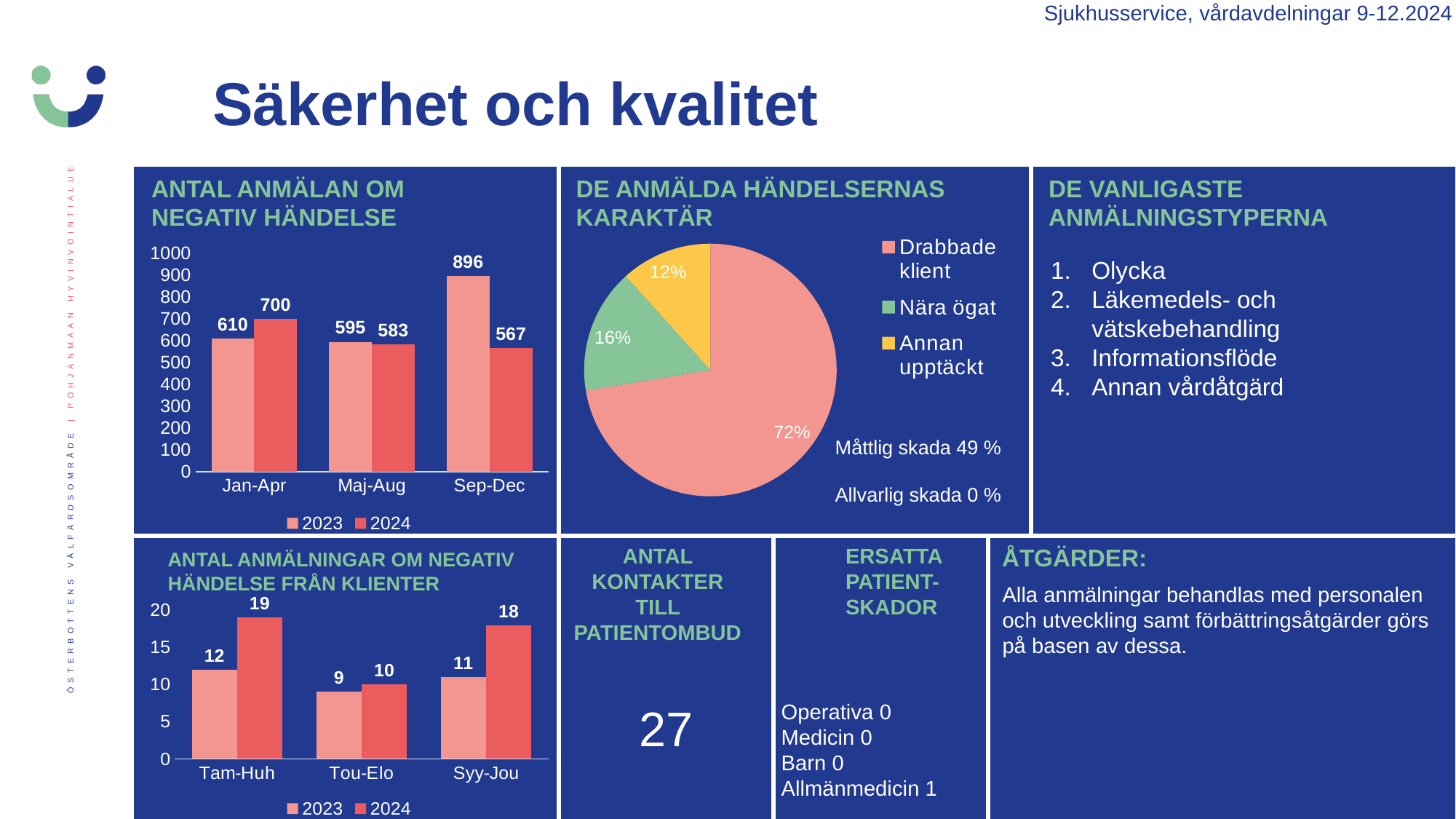
In the chart 'ANTAL ANMÄLAN OM NEGATIV HÄNDELSE', what is the difference between the 2023 and 2024 values in Sep-Dec? 329 In the pie chart 'DE ANMÄLDA HÄNDELSERNAS KARAKTÄR', which category has the largest slice? Drabbade klient In the pie chart 'DE ANMÄLDA HÄNDELSERNAS KARAKTÄR', what share does 'Nära ögat' have? 16% In the chart 'ANTAL ANMÄLNINGAR OM NEGATIV HÄNDELSE FRÅN KLIENTER', what is the value for 2024 in Tam-Huh? 19 In the chart 'ANTAL ANMÄLAN OM NEGATIV HÄNDELSE', which period has the highest 2023 value? Sep-Dec In the chart 'ANTAL ANMÄLAN OM NEGATIV HÄNDELSE', which is larger in Maj-Aug, the 2023 value or the 2024 value? 2023 How many series does the legend of the chart 'ANTAL ANMÄLAN OM NEGATIV HÄNDELSE' list? 2 What kind of chart is 'DE ANMÄLDA HÄNDELSERNAS KARAKTÄR'? Pie chart In the chart 'ANTAL ANMÄLAN OM NEGATIV HÄNDELSE', what is the value for 2023 in Sep-Dec? 896 How many categories are shown on the x axis of the chart 'ANTAL ANMÄLNINGAR OM NEGATIV HÄNDELSE FRÅN KLIENTER'? 3 In the chart 'ANTAL ANMÄLNINGAR OM NEGATIV HÄNDELSE FRÅN KLIENTER', which category has the lowest 2023 value? Tou-Elo In the chart 'ANTAL ANMÄLAN OM NEGATIV HÄNDELSE', what is the value for 2024 in Jan-Apr? 700